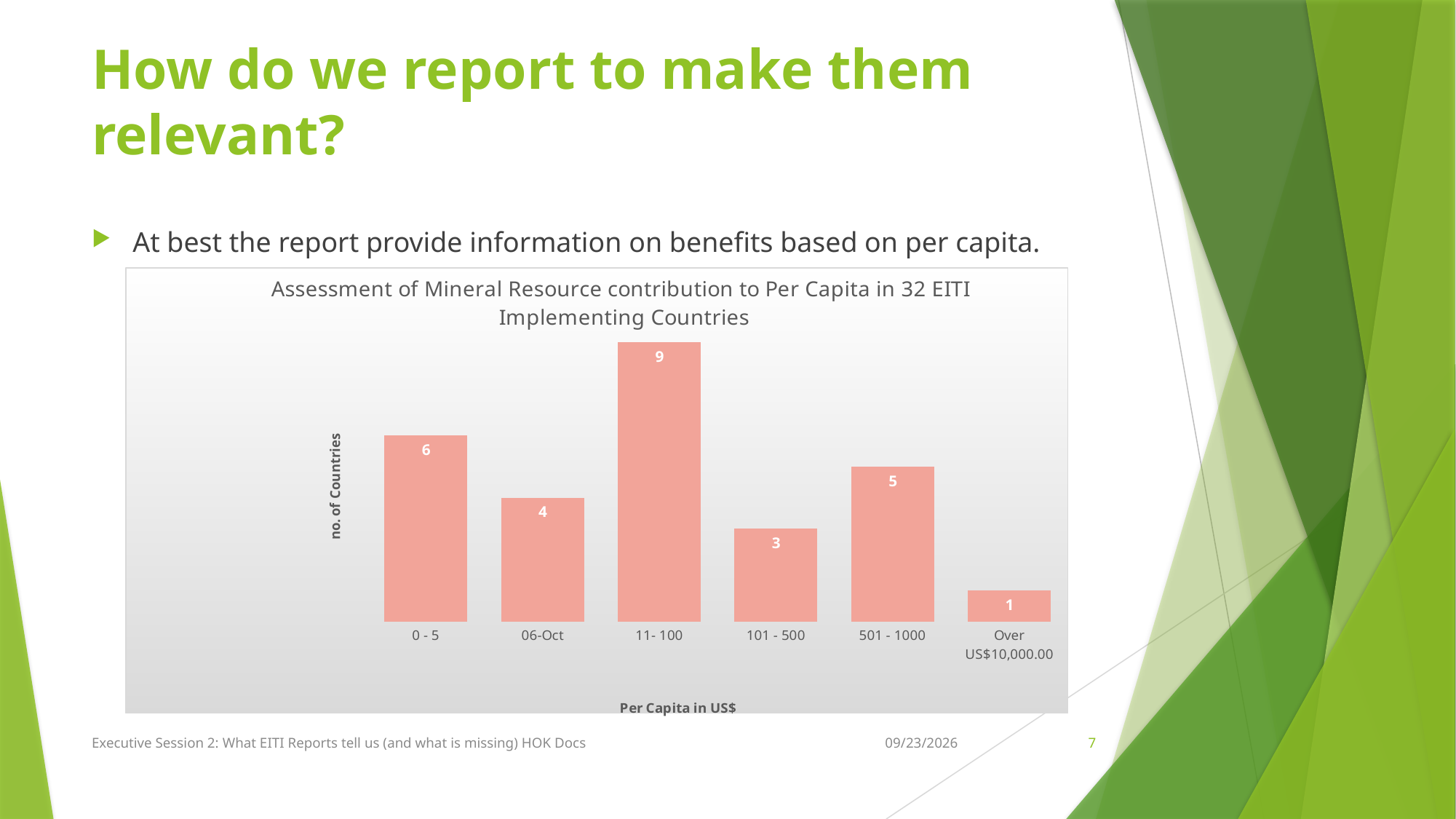
What is the difference in number of countries between the 11- 100 and 101 - 500 categories? 6 What is the number of countries for the 11- 100 per capita category? 9 What is the number of countries for the 501 - 1000 per capita category? 5 Which per capita category has the highest number of countries? 11- 100 What is the label of the x axis of the chart? Per Capita in US$ What is the title of the chart? Assessment of Mineral Resource contribution to Per Capita in 32 EITI Implementing Countries What type of chart is shown on the slide? Bar chart Which per capita category has the lowest number of countries? Over US$10,000.00 Which has more countries, the 06-Oct category or the 501 - 1000 category? 501 - 1000 What is the number of countries for the 0 - 5 per capita category? 6 What is the number of countries for the Over US$10,000.00 category? 1 How many per capita categories are shown on the x axis? 6